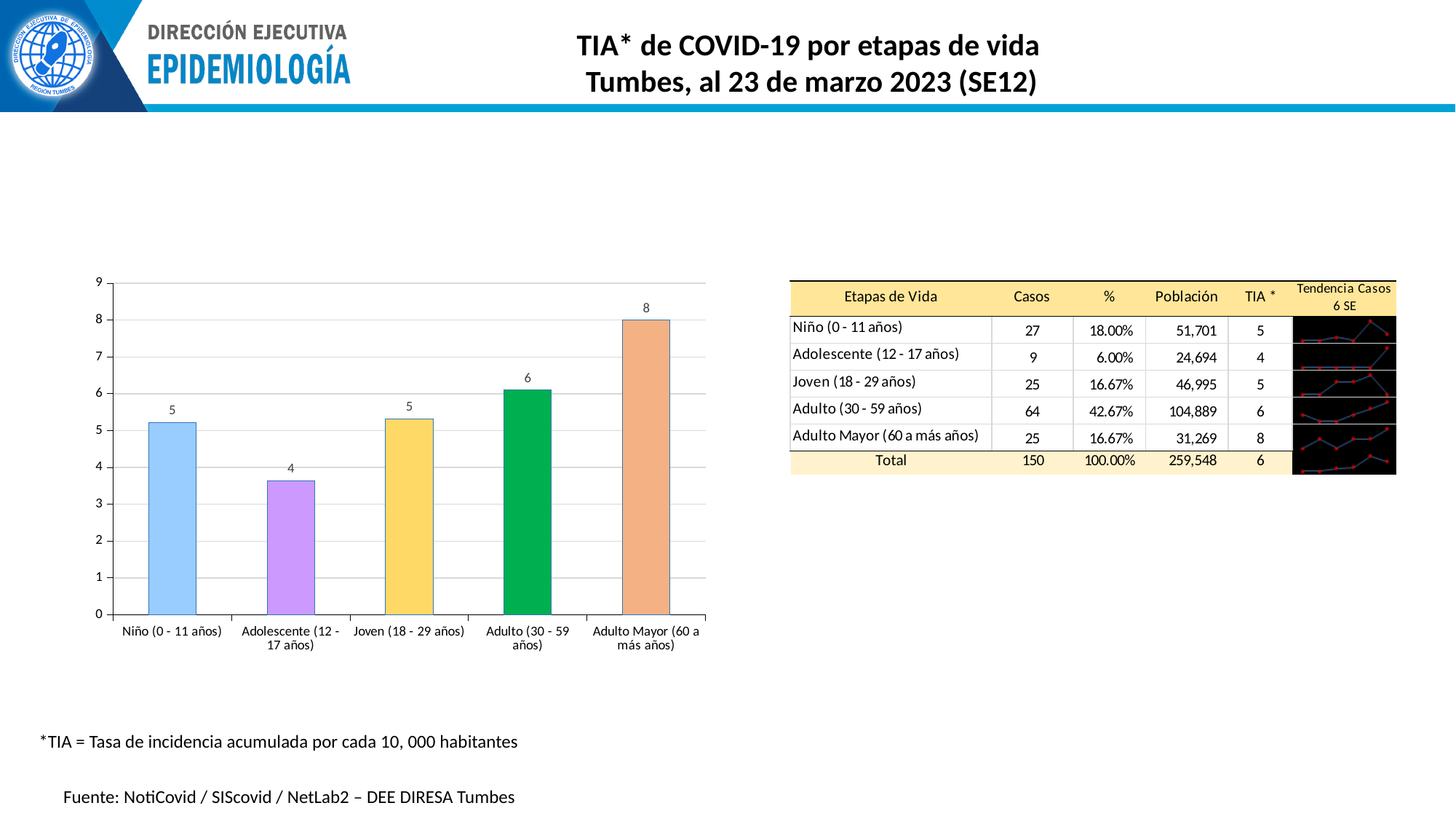
Which is larger in the bar chart, the value for Adulto (30 - 59 años) or for Adolescente (12 - 17 años)? Adulto (30 - 59 años) Is the value for Adulto Mayor (60 a más años) greater or less than 7? greater What kind of chart is used to show the TIA by age group? Bar chart Which age group has the lowest bar in the chart? Adolescente (12 - 17 años) Using the data labels, what is the difference between the values for Adulto Mayor (60 a más años) and Adulto (30 - 59 años)? 2 What is the value shown for Adolescente (12 - 17 años) in the bar chart? 4 How many age-group categories are plotted in the bar chart? 5 What is the value shown for Adulto (30 - 59 años) in the bar chart? 6 Is the value for Adolescente (12 - 17 años) greater or less than 5? less Which age group has the highest bar in the chart? Adulto Mayor (60 a más años) What is the value shown for Adulto Mayor (60 a más años) in the bar chart? 8 Using the data labels, what is the difference between the values for Adulto Mayor (60 a más años) and Adolescente (12 - 17 años)? 4